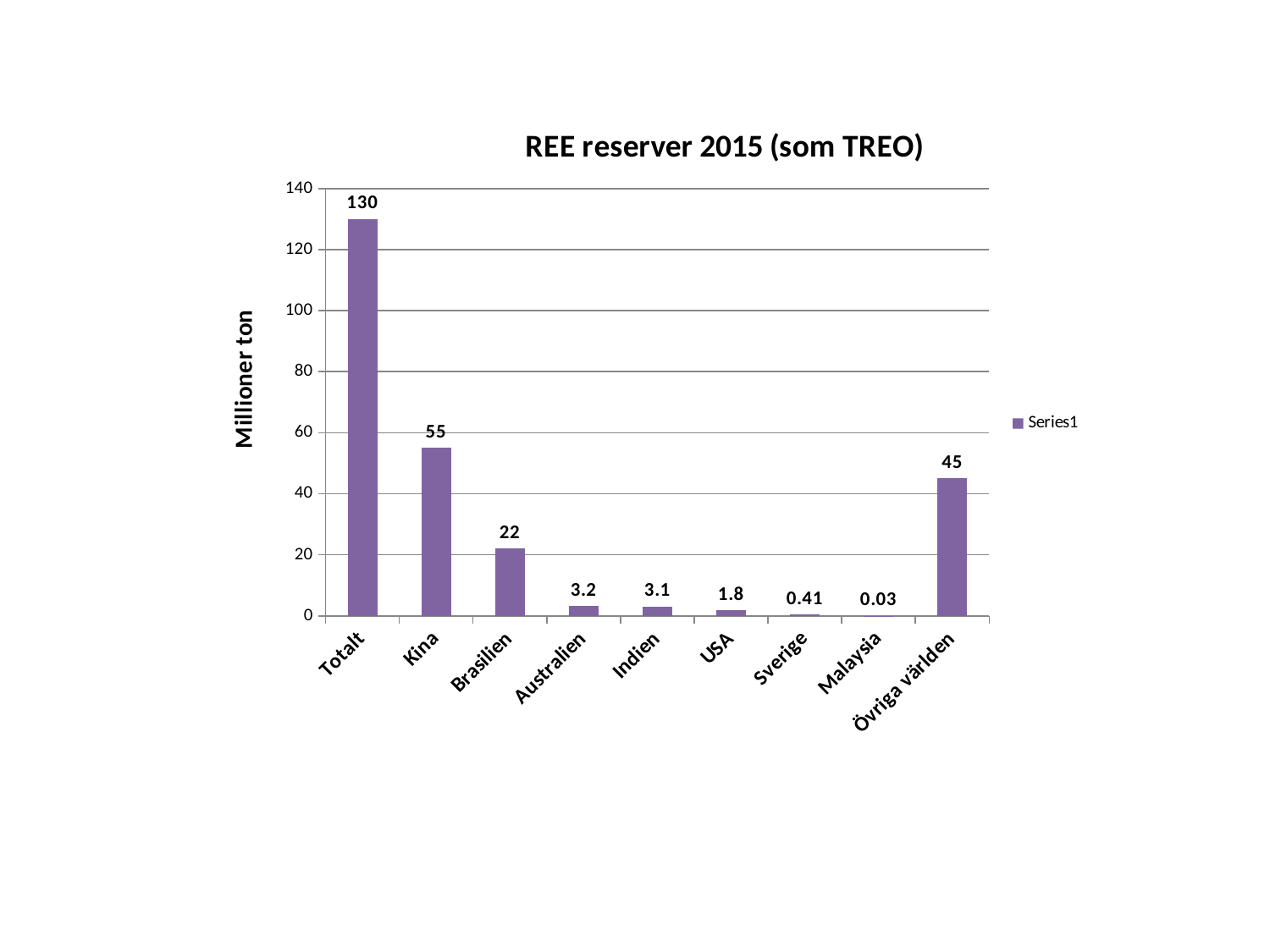
Which category has the lowest value? Malaysia What is the value for Sverige? 0.41 What is the value for Kina? 55 What is the value for Övriga världen? 45 Which category has the highest value? Totalt How many categories are shown on the x axis? 9 What is the value for Malaysia? 0.03 Which is larger, the value for Australien or the value for USA? Australien Is the value for Övriga världen greater or less than 40? greater What is the difference between the values for Kina and Brasilien? 33 What is the title of the chart? REE reserver 2015 (som TREO) What kind of chart is this? bar chart